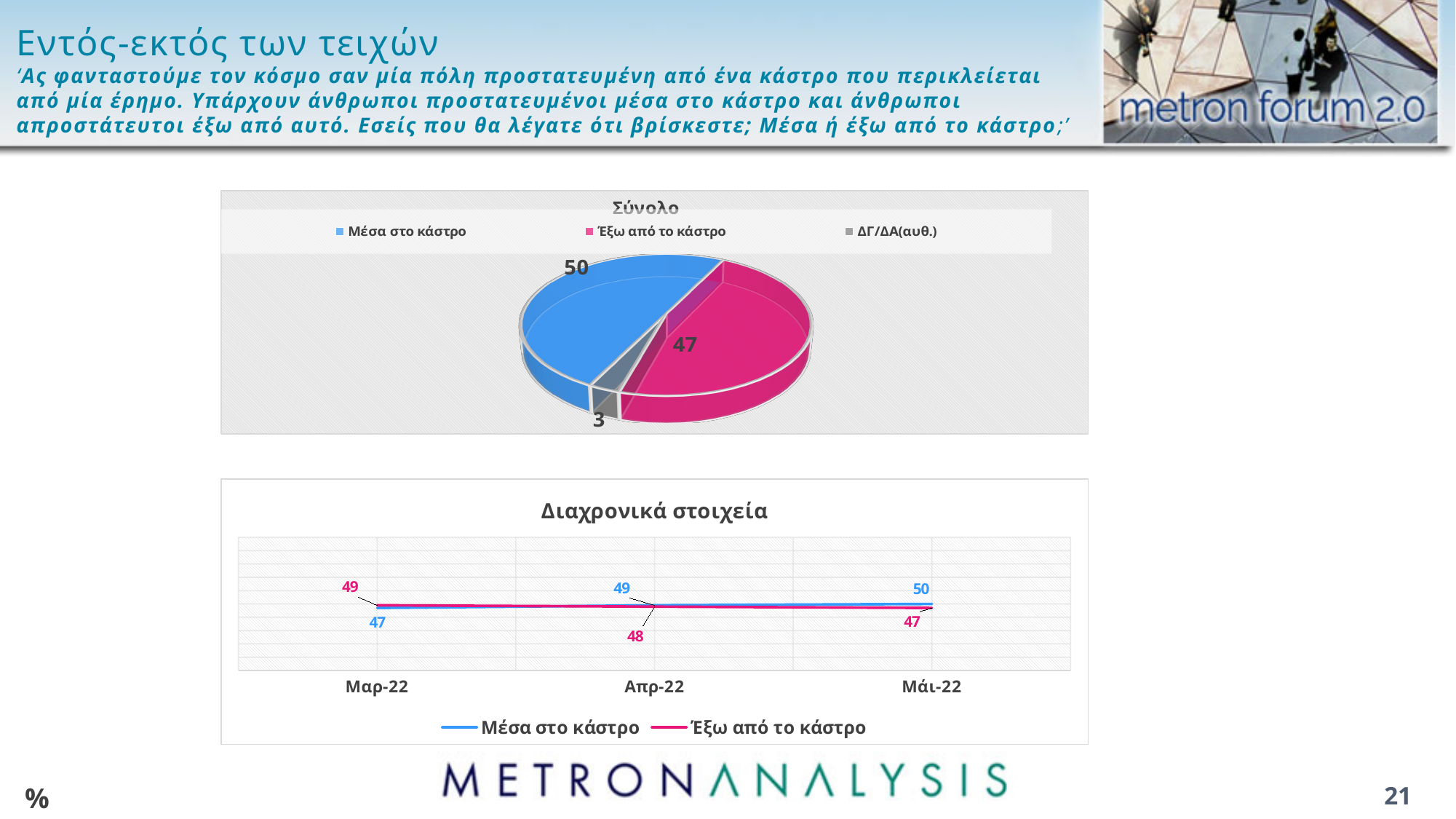
In the chart titled Διαχρονικά στοιχεία, what is the value for Μέσα στο κάστρο in Μάι-22? 50 In the chart titled Διαχρονικά στοιχεία, how many time points are shown on the x axis? 3 In the pie chart titled Σύνολο, how many categories does the legend list? 3 In the chart titled Διαχρονικά στοιχεία, does the Μέσα στο κάστρο series rise or fall from Μαρ-22 to Μάι-22? rise In the chart titled Διαχρονικά στοιχεία, what is the value for Μέσα στο κάστρο in Μαρ-22? 47 In the pie chart titled Σύνολο, what is the value for Μέσα στο κάστρο? 50 In the chart titled Διαχρονικά στοιχεία, what is the value for Έξω από το κάστρο in Απρ-22? 48 What kind of chart is the chart titled Διαχρονικά στοιχεία? line chart In the pie chart titled Σύνολο, what is the value for Έξω από το κάστρο? 47 In the pie chart titled Σύνολο, what is the difference between Μέσα στο κάστρο and Έξω από το κάστρο? 3 In the pie chart titled Σύνολο, which category has the smallest slice? ΔΓ/ΔΑ(αυθ.) In the pie chart titled Σύνολο, what is the value for ΔΓ/ΔΑ(αυθ.)? 3